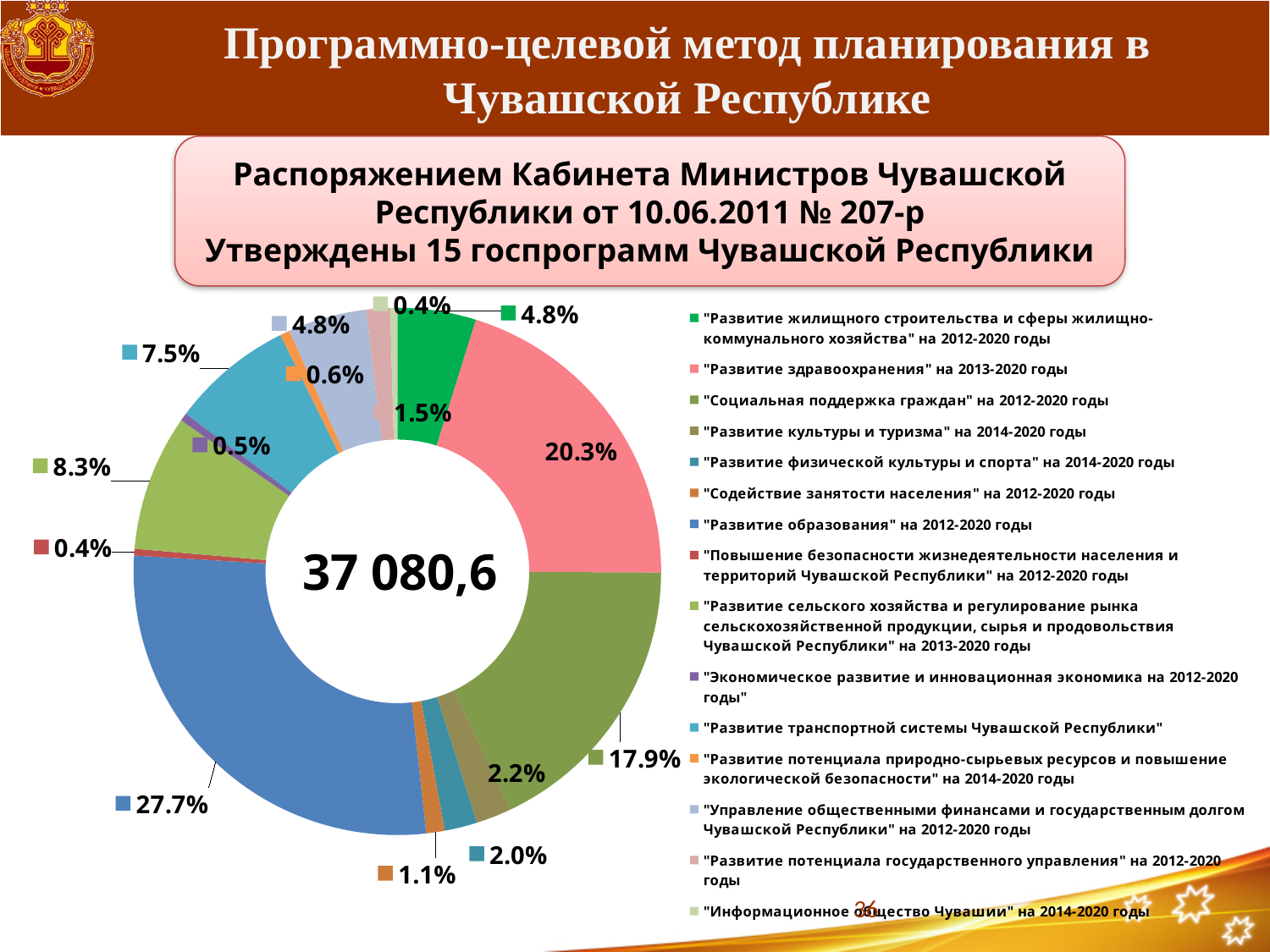
What is the share for "Развитие транспортной системы Чувашской Республики"? 7.5% Which program has the largest share of the chart? "Развитие образования" на 2012-2020 годы What kind of chart is shown on the slide? Doughnut (pie) chart What is the share for "Развитие культуры и туризма" на 2014-2020 годы? 2.2% What value is printed in the centre of the doughnut chart? 37 080,6 What is the share for "Социальная поддержка граждан" на 2012-2020 годы? 17.9% How many slices (categories) does the chart have? 15 What is the share for "Развитие образования" на 2012-2020 годы? 27.7% What is the difference in share between "Развитие образования" and "Развитие здравоохранения"? 7.4% What is the share for "Развитие здравоохранения" на 2013-2020 годы? 20.3% Which has a larger share: "Развитие здравоохранения" or "Социальная поддержка граждан"? "Развитие здравоохранения" на 2013-2020 годы What is the share for "Развитие сельского хозяйства и регулирование рынка сельскохозяйственной продукции, сырья и продовольствия Чувашской Республики" на 2013-2020 годы? 8.3%